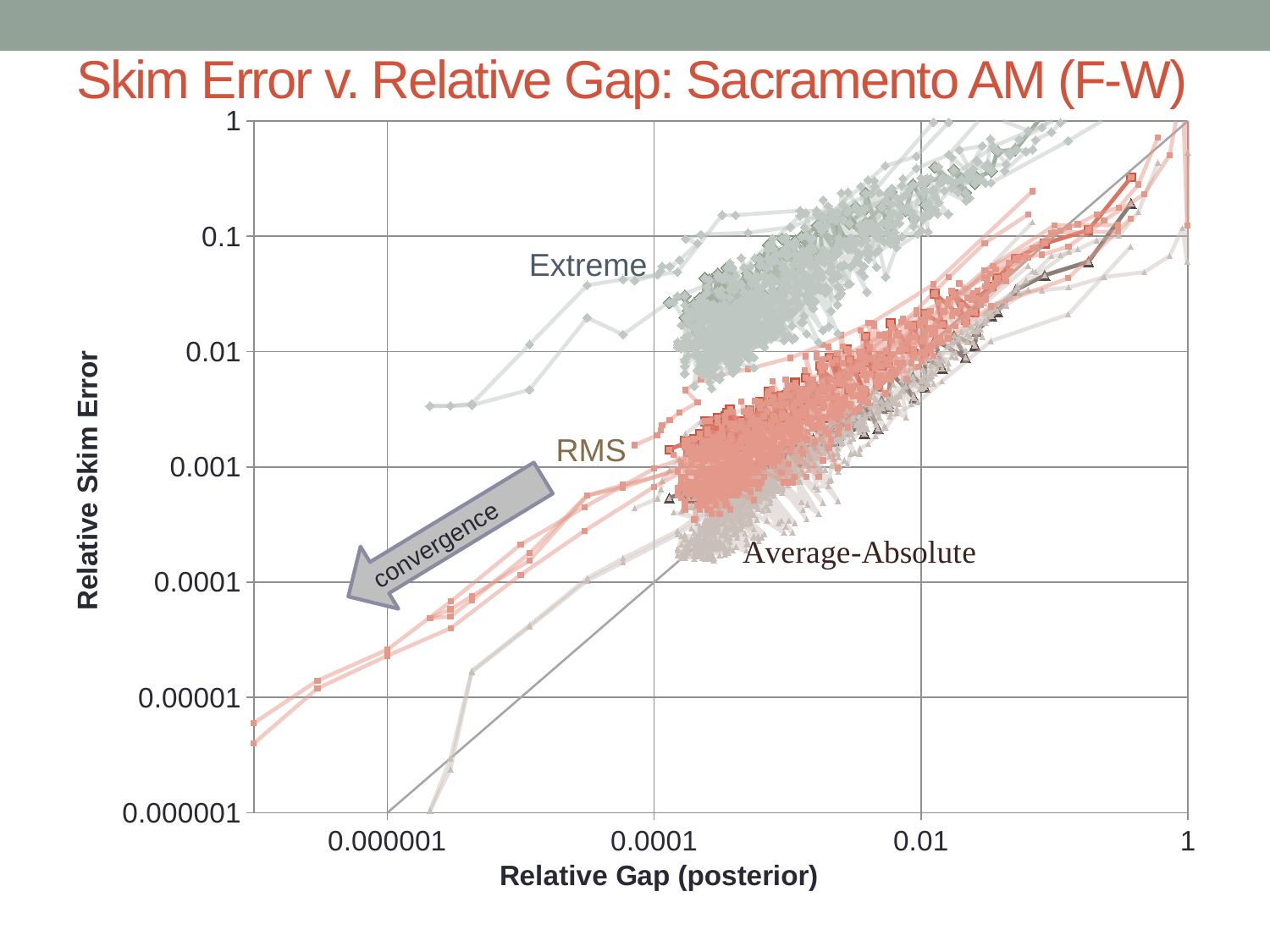
What kind of chart is shown on the slide? scatter chart Does the relative skim error rise or fall as the relative gap increases along the x axis? rise What is the label of the vertical axis? Relative Skim Error What is the highest value shown on the vertical axis? 1 At a relative gap of 0.0001, which series has the larger relative skim error, RMS or Average-Absolute? RMS Which series has the highest relative skim error for a given relative gap? Extreme At a relative gap of 0.0001, is the relative skim error for the Extreme series greater or less than 0.001? greater What is the title of the chart? Skim Error v. Relative Gap: Sacramento AM (F-W) At a relative gap of 0.0001, is the relative skim error for the Average-Absolute series greater or less than 0.01? less How many series are labelled on the chart? 3 At a relative gap of 0.01, which series has the larger relative skim error, Extreme or RMS? Extreme Which series has the lowest relative skim error for a given relative gap? Average-Absolute